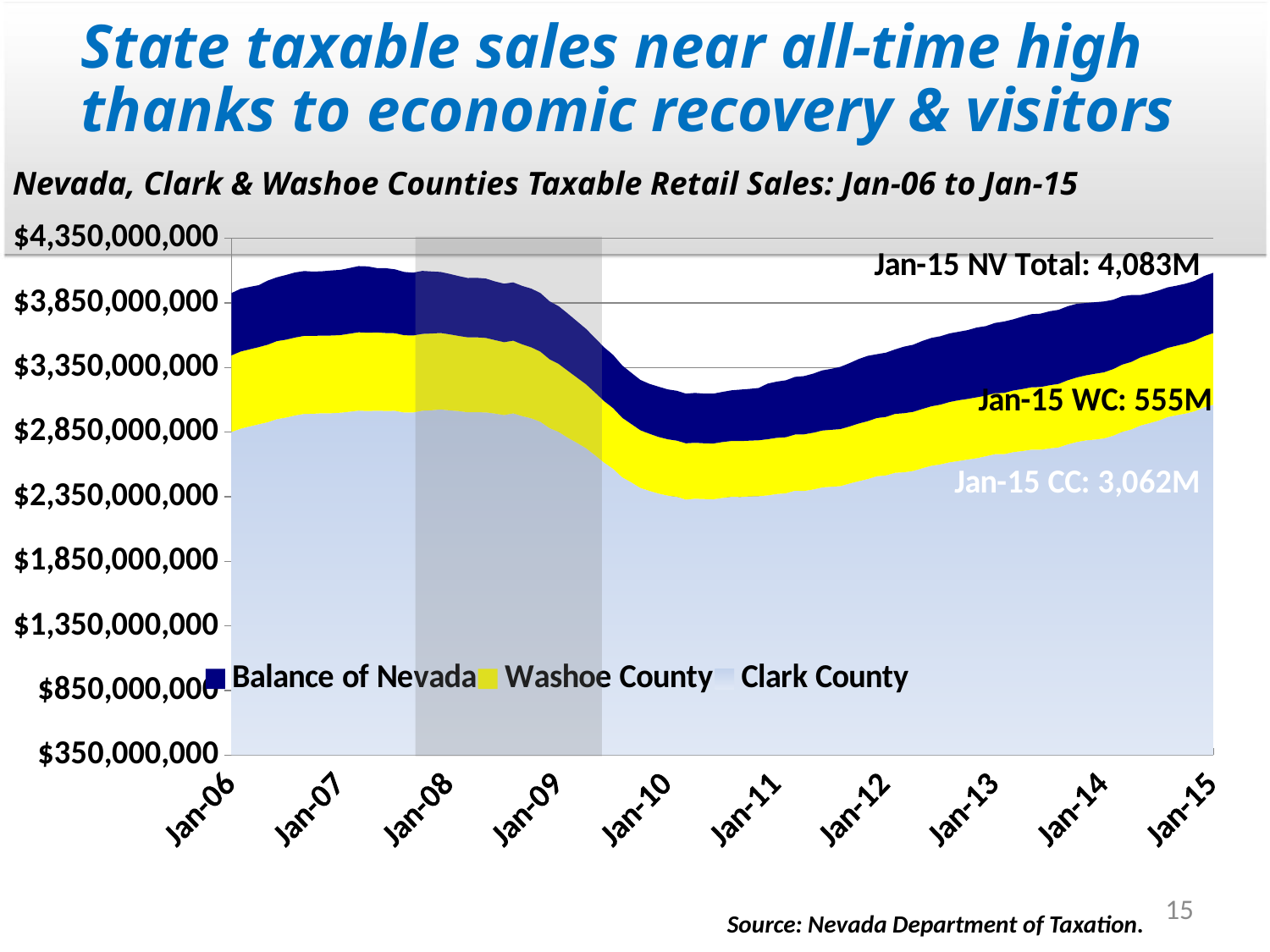
How many year labels are shown on the x axis? 10 Which series contributes the most to the total at Jan-15? Clark County What is the Jan-15 NV Total shown on the chart? 4,083M What kind of chart is shown on the slide? Stacked area chart Is the total taxable sales value at Jan-10 greater or less than $3,350,000,000? less What is the Jan-15 value labelled for Washoe County (WC)? 555M How many series does the legend list? 3 Is the total taxable sales value at Jan-07 greater or less than $3,850,000,000? greater At Jan-15, which is larger: the Clark County value or the Washoe County value? Clark County Using the Jan-15 labels, what is the difference between the Clark County value and the Washoe County value? 2,507M What is the Jan-15 value labelled for Clark County (CC)? 3,062M Does the total taxable sales value rise or fall from Jan-10 to Jan-15? rise